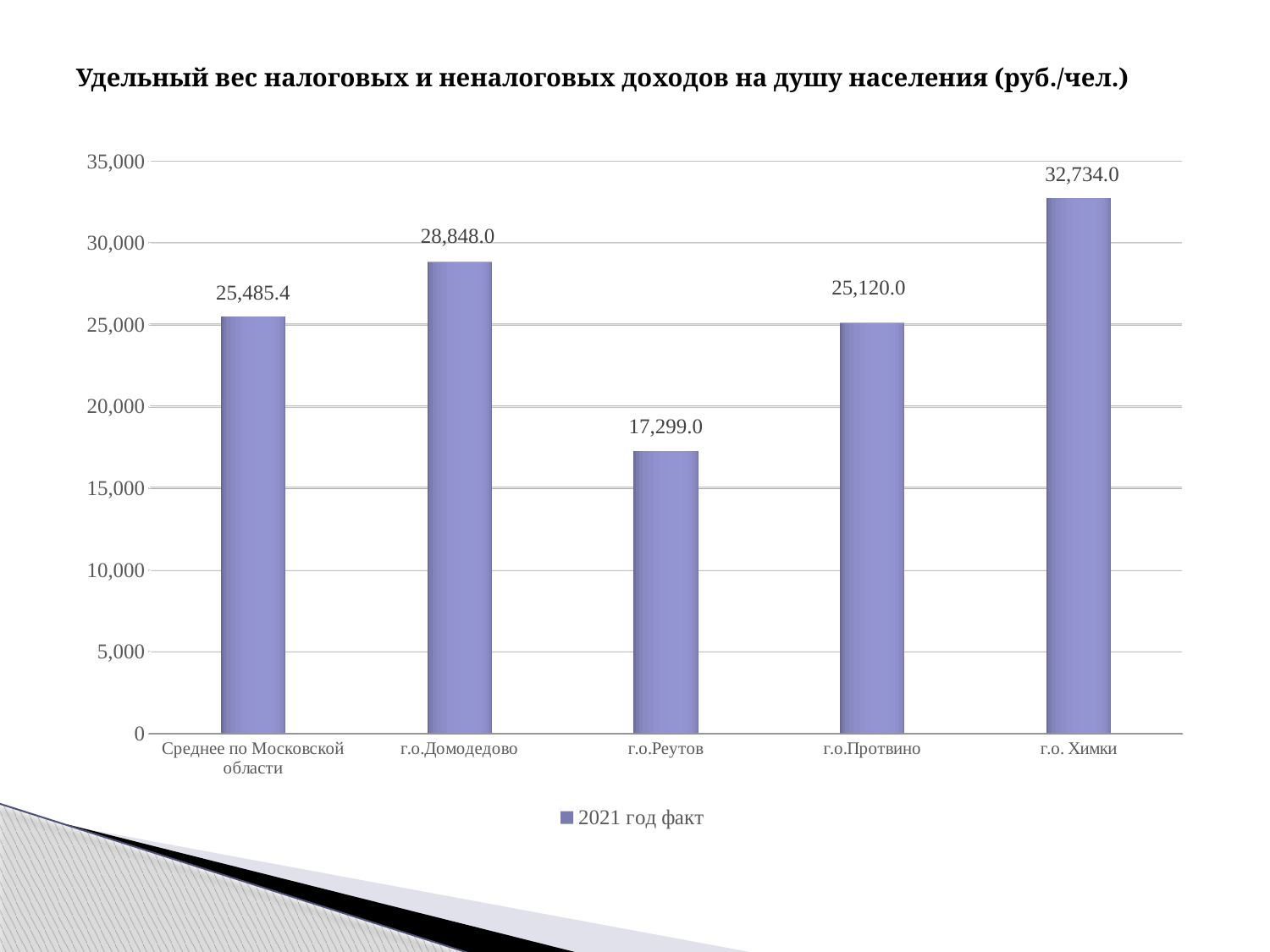
What is the difference between the values for г.о.Домодедово and г.о.Протвино? 3,728.0 Which category has the lowest value? г.о.Реутов How many series does the legend list? 1 Which is larger, the value for г.о.Домодедово or the value for г.о.Протвино? г.о.Домодедово What kind of chart is shown on the slide? bar chart What is the value for г.о.Реутов? 17,299.0 How many categories are shown on the chart? 5 Is the value for г.о.Реутов greater or less than 20,000? less What is the value for г.о.Домодедово? 28,848.0 What is the difference between the values for г.о. Химки and г.о.Реутов? 15,435.0 Which category has the highest value? г.о. Химки What is the value for Среднее по Московской области? 25,485.4